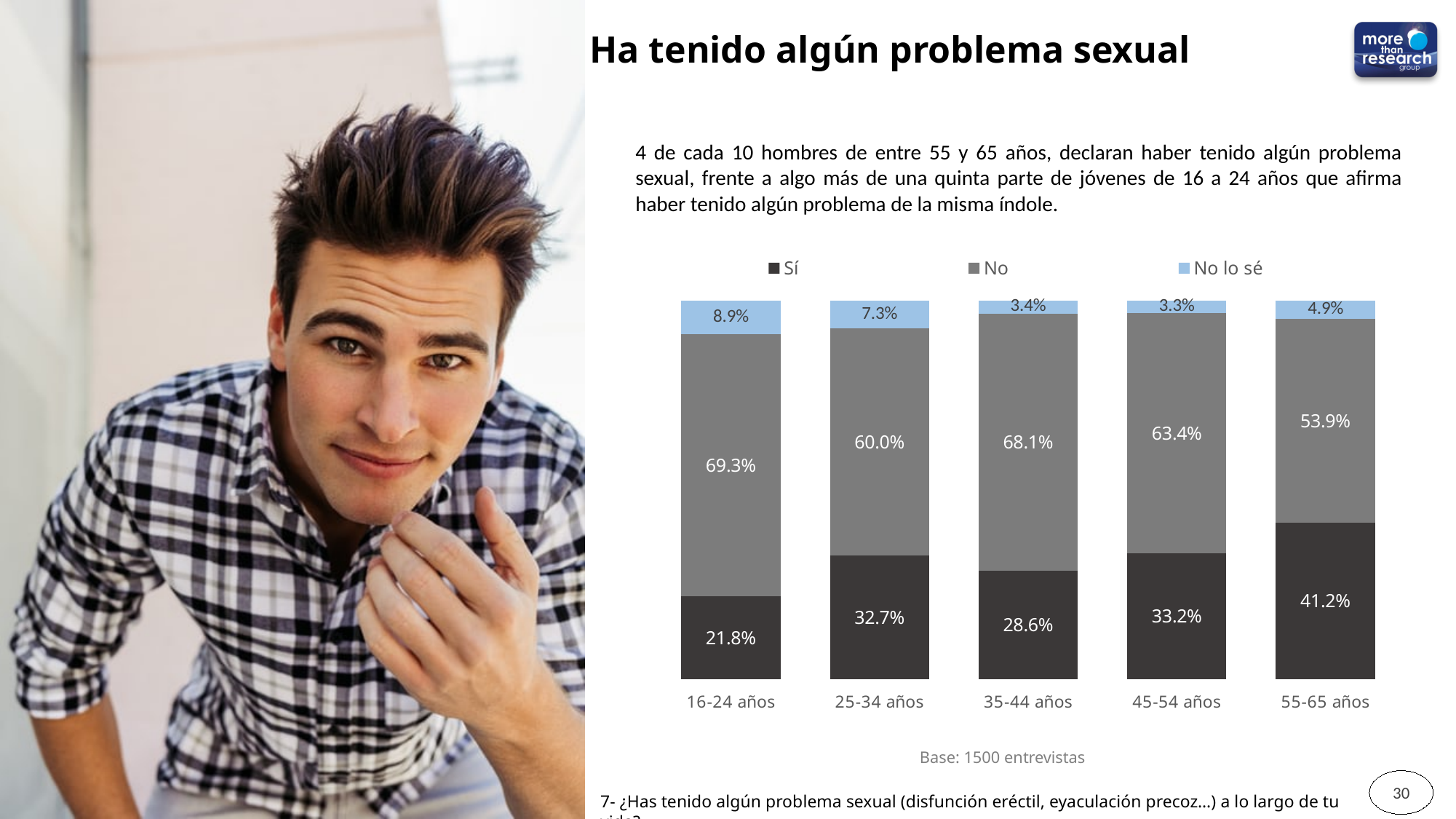
What is the No lo sé value for the 25-34 años group? 7.3% What is the No value for the 16-24 años group? 69.3% How many series does the legend list? 3 Which age group has the highest Sí value? 55-65 años What percentage of men aged 55-65 años answered Sí? 41.2% Which age group has the lowest No lo sé value? 45-54 años Which age group has the lowest Sí value? 16-24 años How many age groups are shown on the x axis? 5 What is the difference between the Sí values for 55-65 años and 16-24 años? 19.4% What kind of chart is shown on the slide? Stacked bar chart What is the base (number of interviews) stated below the chart? 1500 entrevistas Which is larger, the No value for 35-44 años or for 45-54 años? 35-44 años